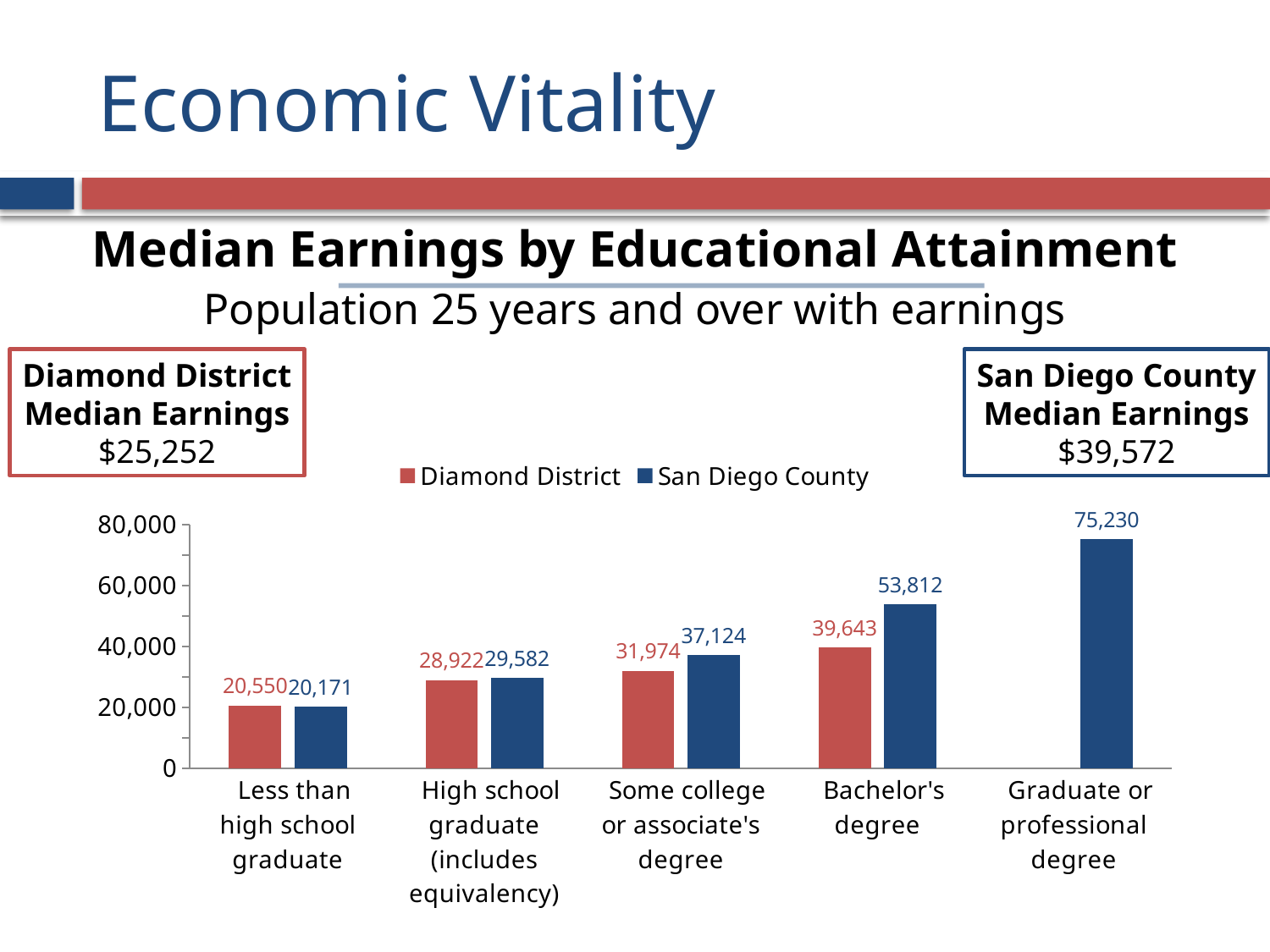
What is the San Diego County value for Some college or associate's degree? 37,124 How many educational attainment categories are shown on the x axis? 5 Which educational attainment category has the highest San Diego County median earnings? Graduate or professional degree How many series does the legend list? 2 What kind of chart is shown on the slide? Bar chart What is the Diamond District value for Less than high school graduate? 20,550 What is the difference between the San Diego County and Diamond District values for Bachelor's degree? 14,169 Is the San Diego County value for Graduate or professional degree greater or less than 60,000? greater For Less than high school graduate, which is larger: the Diamond District value or the San Diego County value? Diamond District Which educational attainment category has the lowest Diamond District median earnings? Less than high school graduate What is the San Diego County median earnings value for Graduate or professional degree? 75,230 What is the Diamond District median earnings value for Bachelor's degree? 39,643